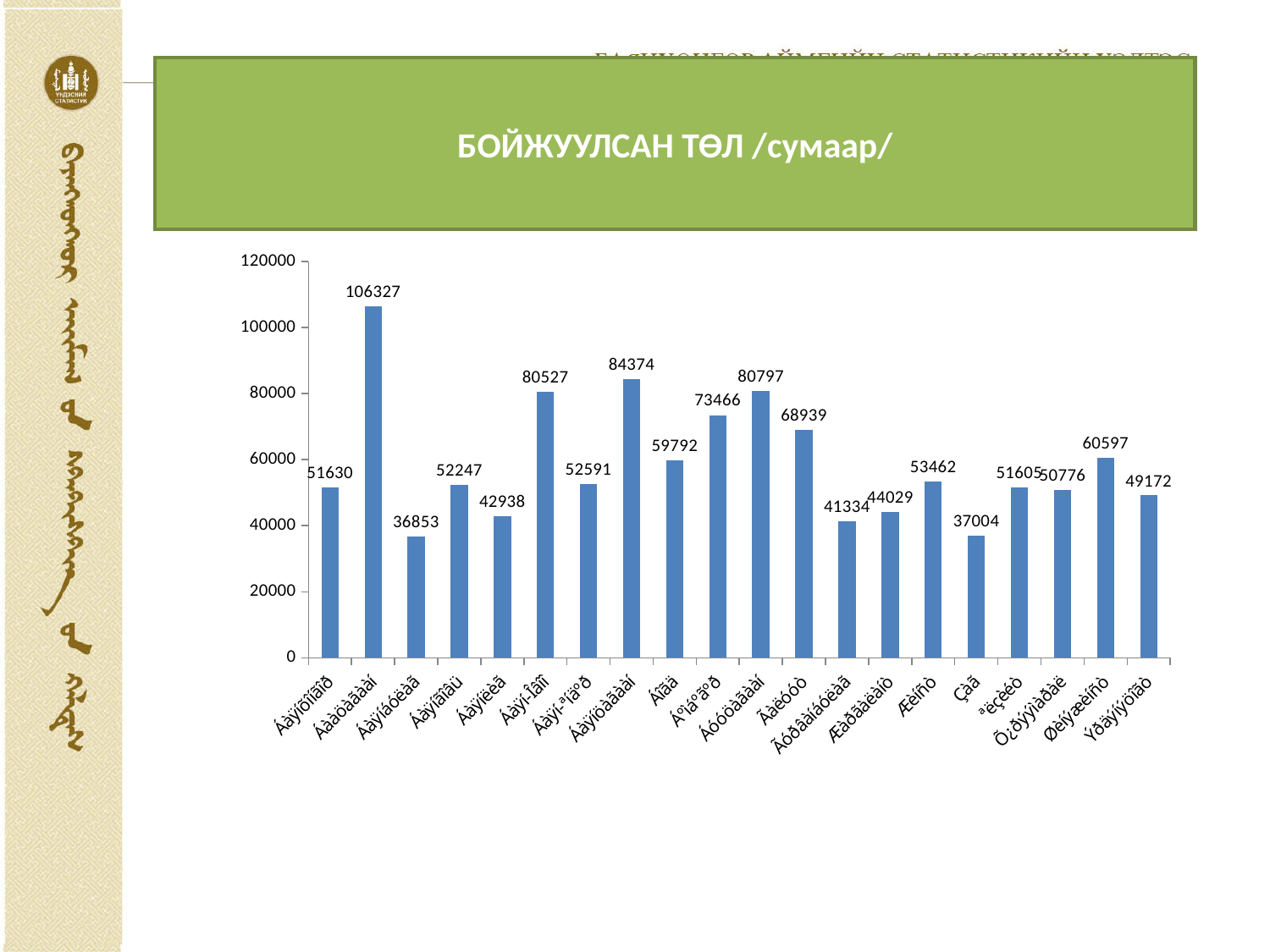
What type of chart is shown on the slide? bar chart What is the highest value shown in the chart? 106327 What is the value of the rightmost bar in the chart? 49172 What is the lowest value shown in the chart? 36853 What is the title of the chart? БОЙЖУУЛСАН ТӨЛ /сумаар/ Which is larger, the leftmost bar (51630) or the rightmost bar (49172)? the leftmost bar (51630) What is the maximum value shown on the vertical axis? 120000 What is the value of the leftmost bar in the chart? 51630 How many bars are plotted in the chart? 20 What is the difference between the highest value (106327) and the lowest value (36853) in the chart? 69474 What is the value of the second bar from the left? 106327 Is the value of the fourth bar from the left greater or less than 60000? less